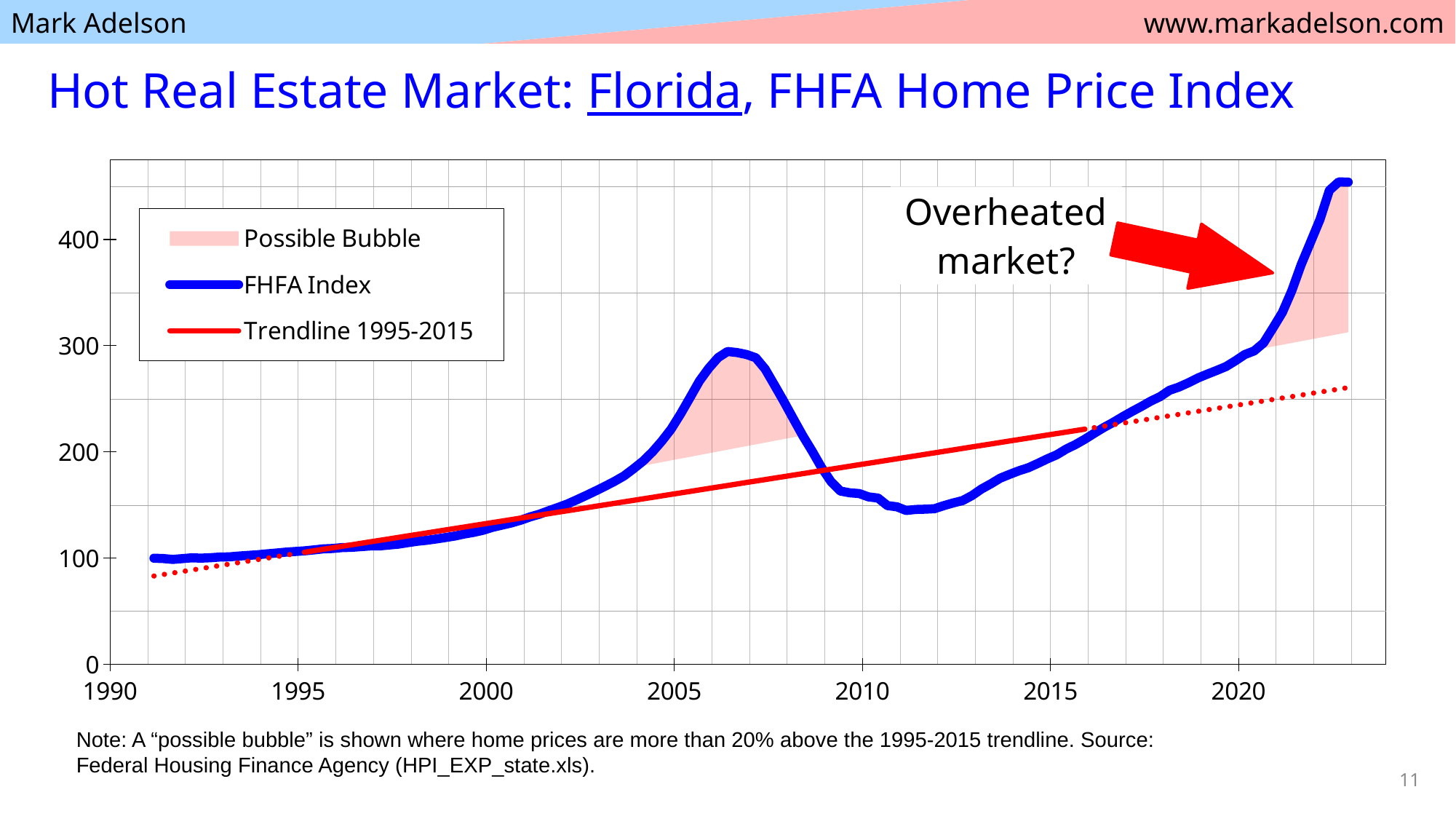
Which is higher for the FHFA Index: the peak around 2006 or the peak at the end of the series around 2022-2023? the peak around 2022-2023 How many entries does the chart legend list? 3 Is the FHFA Index value at its 2006 peak greater or less than 200? greater Overall, does the FHFA Index rise or fall from 1991 to 2023? rise What colour is the FHFA Index line in the chart? blue Which is larger for the FHFA Index: the value in 2006 or the value in 2011? 2006 Is the FHFA Index value at the end of the series (around 2023) greater or less than 400? greater How many shaded 'Possible Bubble' regions are shown on the chart? 2 Is the FHFA Index value in 2011 greater or less than 200? less What kind of chart is shown on the slide? line chart What is the title of the slide's chart? Hot Real Estate Market: Florida, FHFA Home Price Index